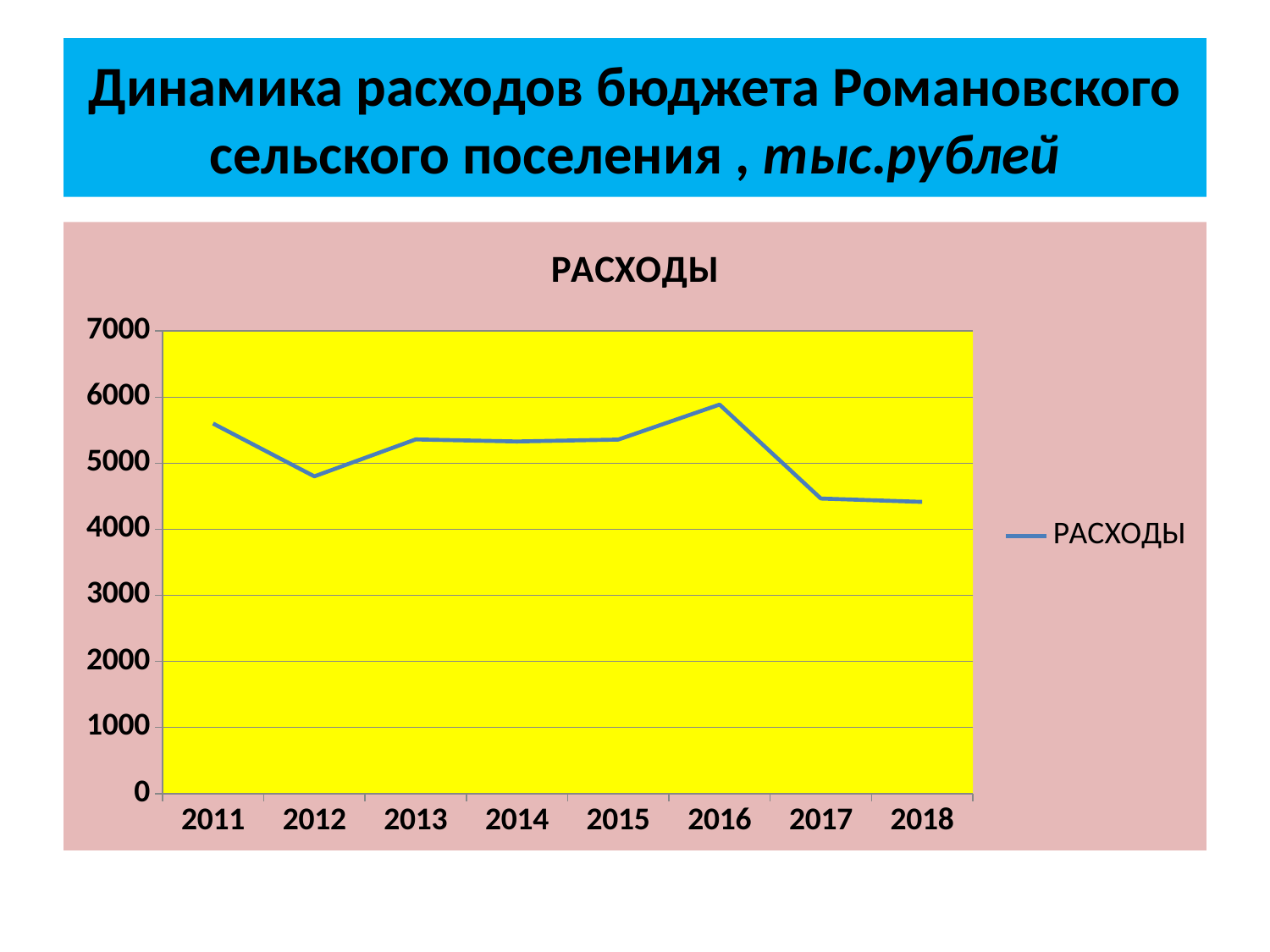
How many years are plotted on the x axis of the chart? 8 Is the value for 2016 greater or less than 5000? greater In which year is the value of РАСХОДЫ highest? 2016 What is the title of the chart? РАСХОДЫ Which year has the larger value, 2011 or 2012? 2011 Is the value for 2011 greater or less than 5000? greater Is the value for 2017 greater or less than 5000? less Do the values rise or fall from 2016 to 2018? fall What is the name of the series shown in the legend? РАСХОДЫ How many series does the chart's legend list? 1 What kind of chart is shown on the slide? line chart